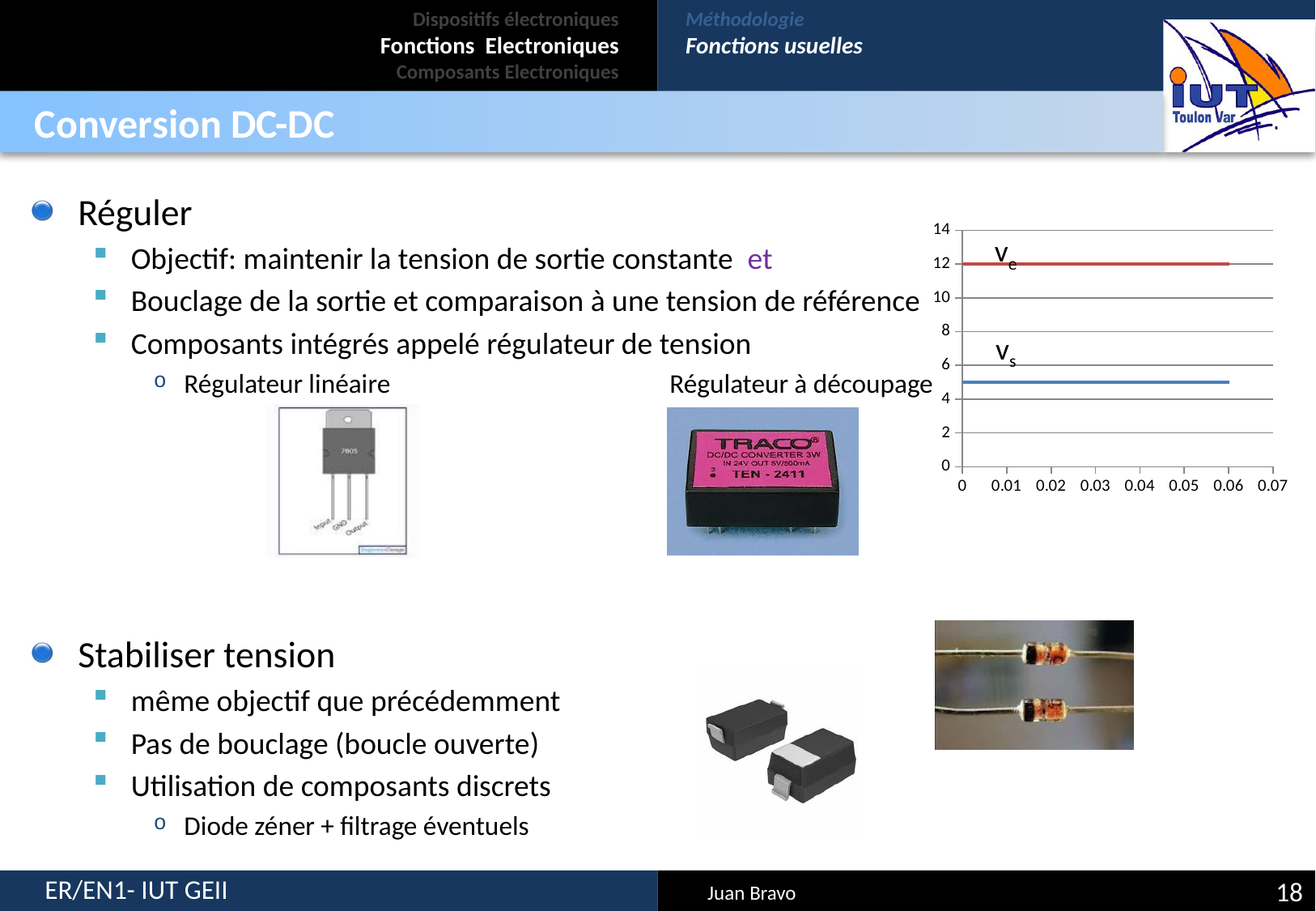
What colour is the Vs line in the chart? blue Is the value of the Vs line greater or less than 4? greater Which of the two plotted series has the lowest value? Vs How many series are plotted in the chart? 2 Which of the two plotted series has the highest value? Ve Is the value of the Ve line greater or less than 10? greater Which line is higher, Ve or Vs? Ve What is the maximum value shown on the y axis of the chart? 14 Do the values of the Ve line rise, fall or stay constant along the x axis? stay constant What value does the Ve line sit at on the y axis? 12 What kind of chart is shown on the right of the slide? line chart Is the value of the Vs line greater or less than 6? less